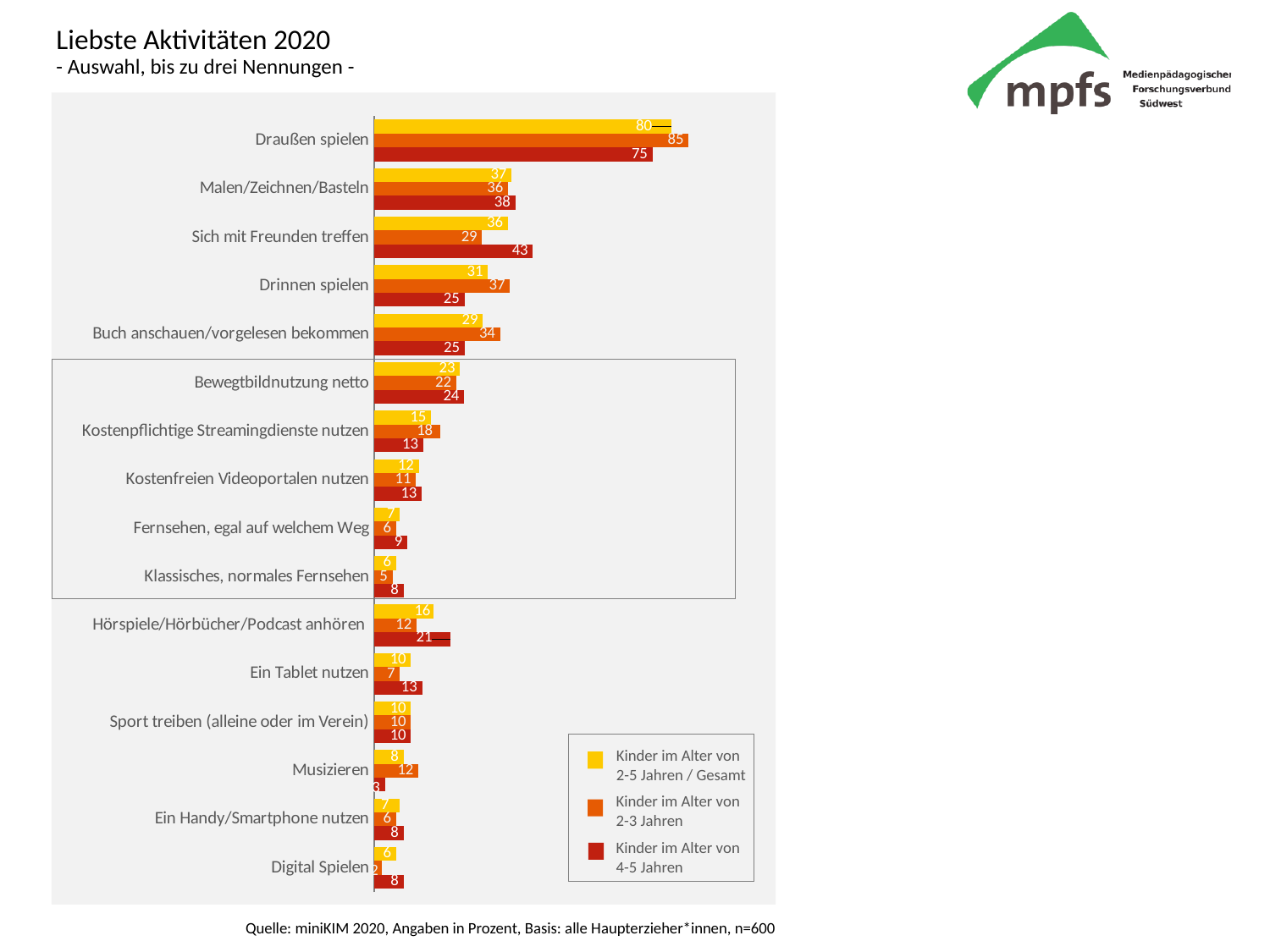
What is the value for Sich mit Freunden treffen for Kinder im Alter von 4-5 Jahren? 43 What kind of chart is shown on the slide? Bar chart What is the title of the chart? Liebste Aktivitäten 2020 How many activities are shown in the chart? 16 What is the value for Ein Tablet nutzen for Kinder im Alter von 2-3 Jahren? 7 How many series does the legend list? 3 What is the value for Draußen spielen for Kinder im Alter von 2-3 Jahren? 85 What is the value for Hörspiele/Hörbücher/Podcast anhören for Kinder im Alter von 2-5 Jahren / Gesamt? 16 Which activity has the highest value for Kinder im Alter von 4-5 Jahren? Draußen spielen For Musizieren, which is larger: the value for Kinder im Alter von 2-3 Jahren or for Kinder im Alter von 4-5 Jahren? Kinder im Alter von 2-3 Jahren What is the difference between the 2-3 Jahren and 4-5 Jahren values for Drinnen spielen? 12 Which activity has the lowest value for Kinder im Alter von 2-3 Jahren? Digital Spielen